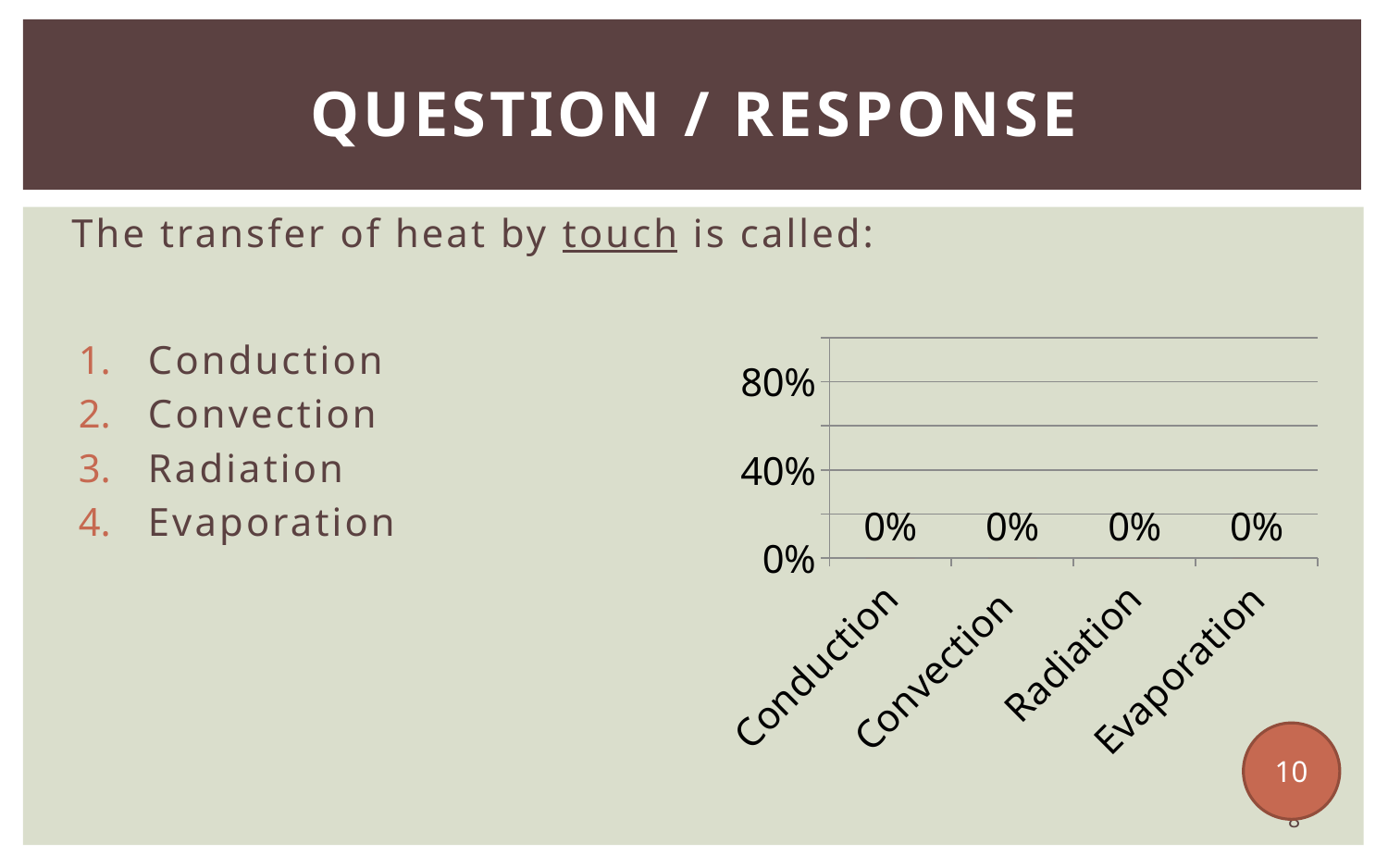
How many categories are plotted on the chart's x axis? 4 What kind of chart is shown on the slide? bar chart Do the values rise, fall, or stay the same across the categories from Conduction to Evaporation? stay the same What is the difference between the values for Conduction and Radiation? 0% What is the label of the first category on the chart's x axis? Conduction What value is shown for Convection in the chart? 0% What is the highest percentage label shown on the chart's vertical axis? 80% What value is shown for Conduction in the chart? 0% Is the value for Evaporation greater or less than 40%? less What value is shown for Evaporation in the chart? 0% What value is shown for Radiation in the chart? 0%